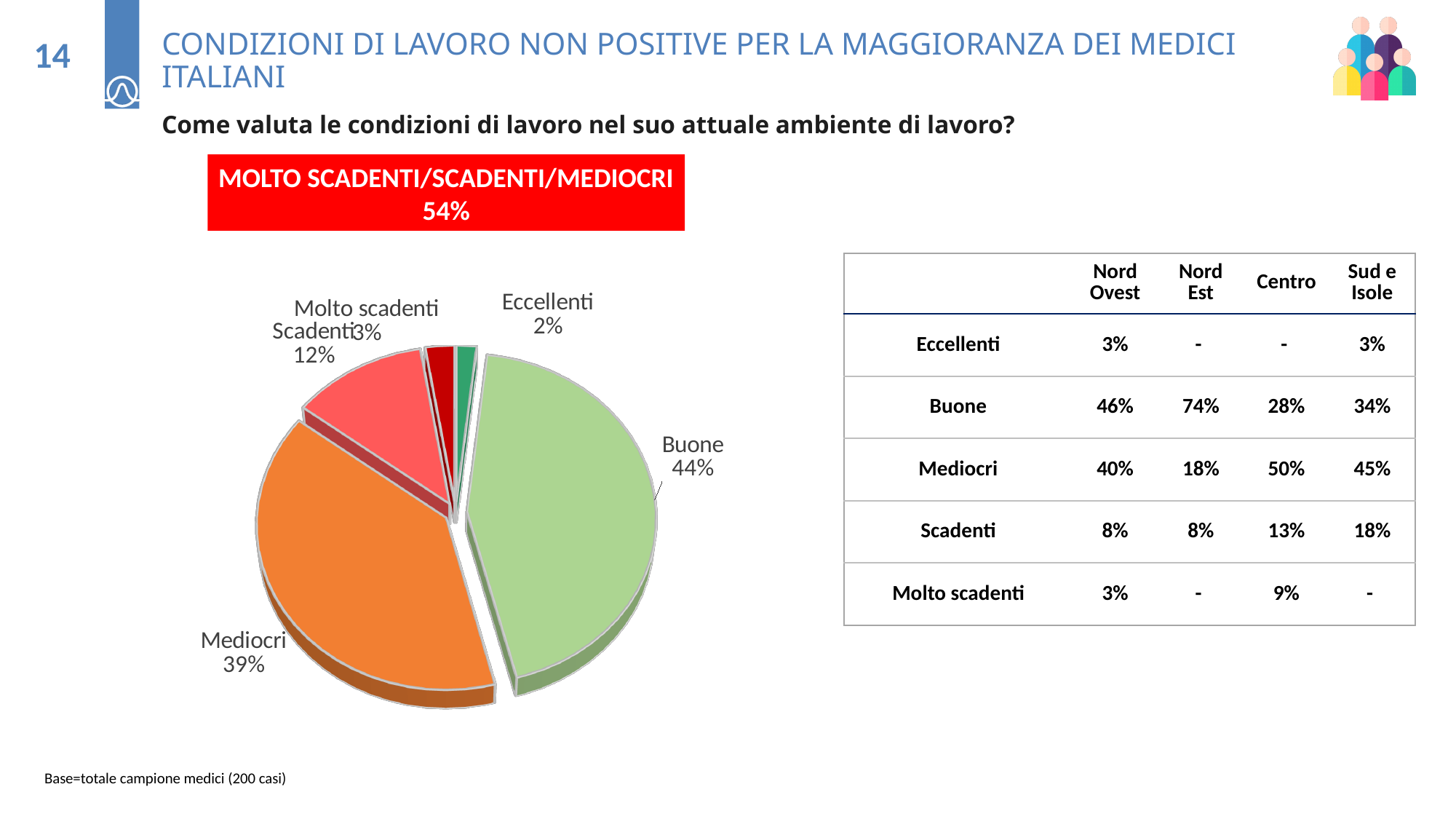
What share of the pie chart is labelled Mediocri? 39% What share of the pie chart is labelled Scadenti? 12% What share of the pie chart is labelled Eccellenti? 2% Which slice of the pie chart is the largest? Buone In the pie chart, what is the difference between the Buone and Mediocri shares? 5% In the pie chart, which is larger: Scadenti or Molto scadenti? Scadenti Which slice of the pie chart is the smallest? Eccellenti How many slices does the pie chart have? 5 What kind of chart is shown on the slide? pie chart What colour is the Mediocri slice in the pie chart? orange